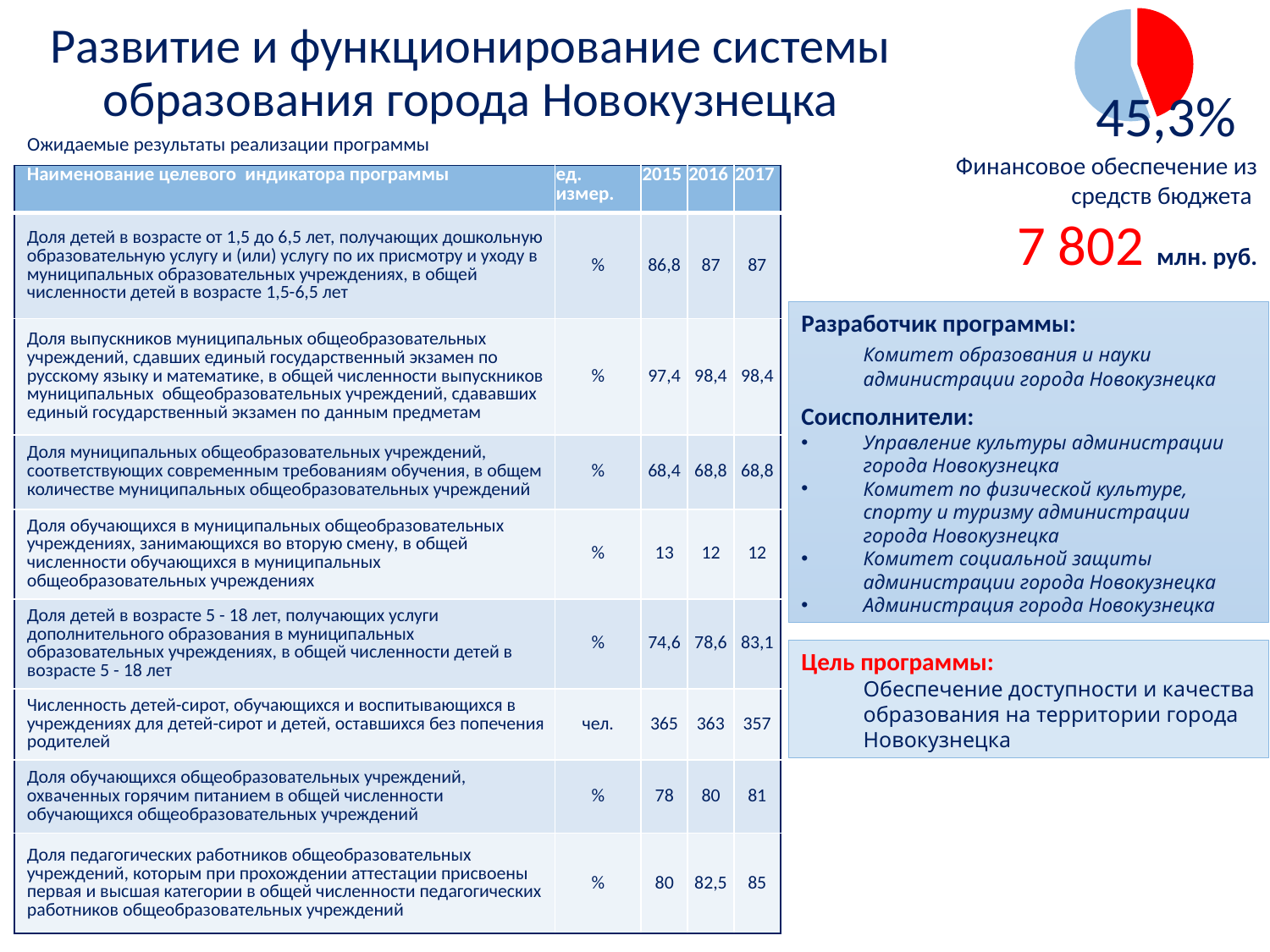
What kind of chart is shown in the top right corner of the slide? pie chart What percentage is printed on the pie chart in the top right corner? 45,3% What share of the pie chart does the red slice represent? 45,3% Is the share of the red slice in the pie chart greater or less than 50%? less In the pie chart, which slice is larger, the red one or the light blue one? the light blue one What colour is the slice of the pie chart that is labelled 45,3%? red How many slices does the pie chart in the top right corner have? 2